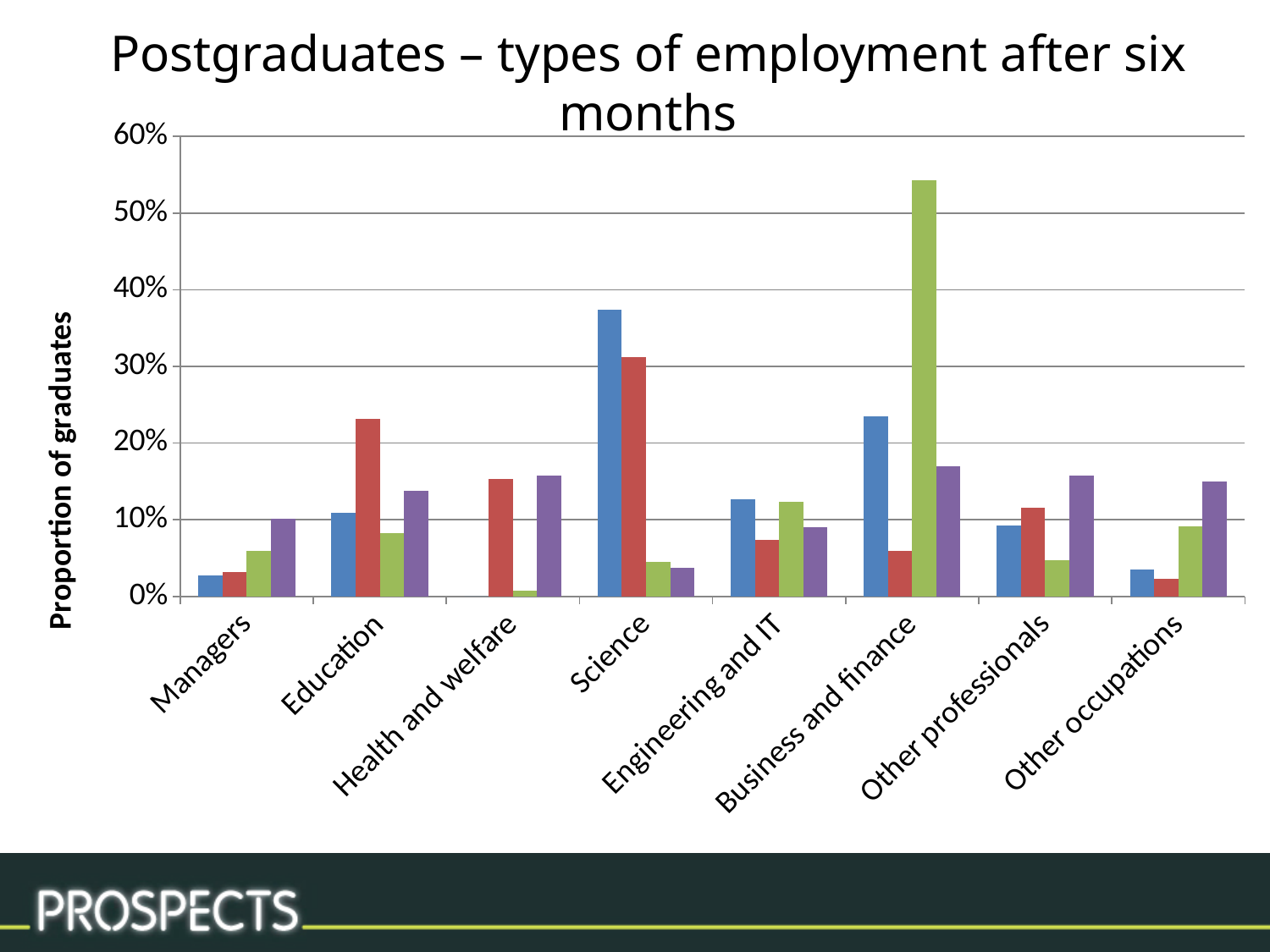
Is the red bar for Education greater or less than 20%? greater How many differently coloured bars are plotted for each occupation category? 4 What is the title of the chart? Postgraduates – types of employment after six months Which category has the tallest blue bar? Science Is the green bar for Business and finance greater or less than 50%? greater What is the label on the vertical axis? Proportion of graduates Which category has the tallest green bar? Business and finance Is the blue bar for Science greater or less than 30%? greater For Science, which is larger, the blue bar or the red bar? the blue bar How many occupation categories are shown along the x axis? 8 What kind of chart is shown on the slide? bar chart